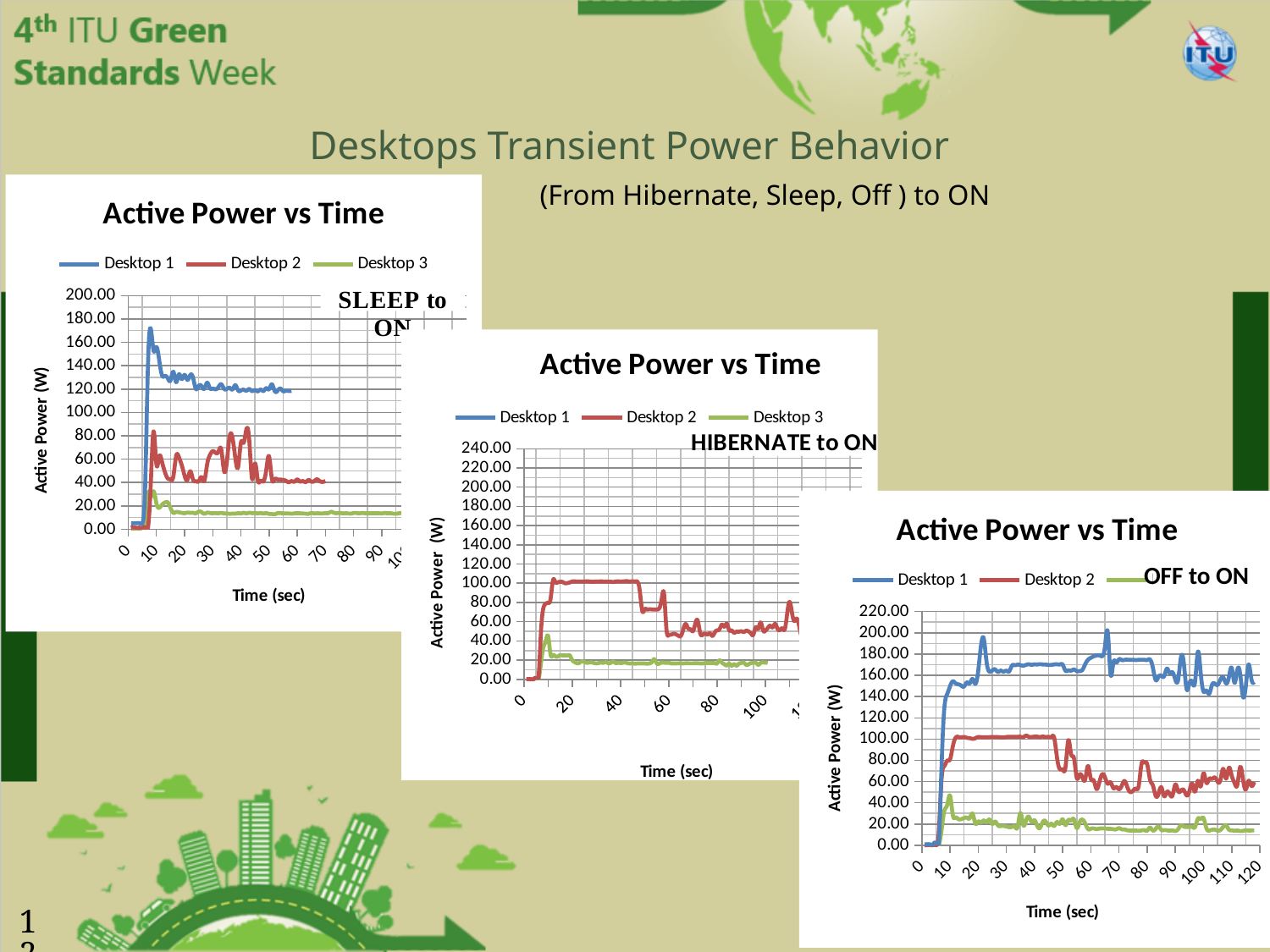
In the "SLEEP to ON" chart, is the peak value for Desktop 1 greater or less than 140.00? greater In the "OFF to ON" chart, which desktop has the lowest active power throughout the time range? Desktop 3 In the "HIBERNATE to ON" chart, is the value for Desktop 3 at 60 seconds greater or less than 40.00? less What kind of chart is the "SLEEP to ON" Active Power vs Time chart? line chart How many series does the legend of the "OFF to ON" chart list? 3 In the "OFF to ON" chart, at 40 seconds, which is larger: the value for Desktop 1 or Desktop 2? Desktop 1 In the "OFF to ON" chart, which desktop has the highest active power throughout the time range? Desktop 1 In the "OFF to ON" chart, is the peak value for Desktop 1 greater or less than 180.00? greater What is the label of the y-axis on the "HIBERNATE to ON" chart? Active Power (W) What is the highest tick value shown on the y-axis of the "HIBERNATE to ON" chart? 240.00 How many Active Power vs Time charts are shown on the slide? 3